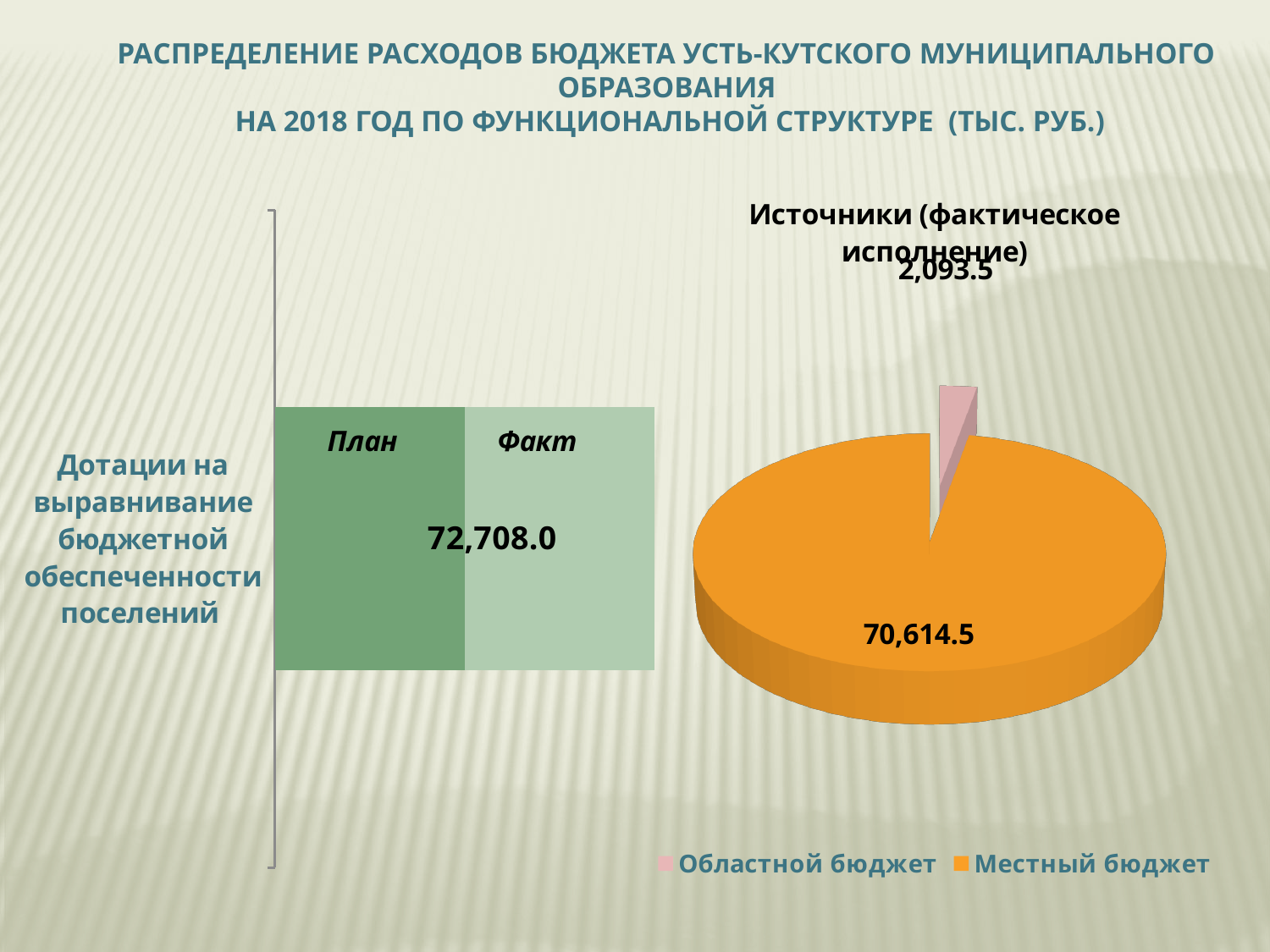
On the bar chart on the left of the slide, what are the two series shown? План and Факт On the pie chart 'Источники (фактическое исполнение)', what share of the total does Областной бюджет represent? 2.9% On the pie chart 'Источники (фактическое исполнение)', what is the difference between Местный бюджет and Областной бюджет? 68,521.0 On the pie chart 'Источники (фактическое исполнение)', what is the total of the two slices? 72,708.0 How many entries does the legend of the pie chart 'Источники (фактическое исполнение)' list? 2 On the pie chart 'Источники (фактическое исполнение)', which source has the largest slice? Местный бюджет On the pie chart 'Источники (фактическое исполнение)', which source has the smallest slice? Областной бюджет How many slices does the pie chart 'Источники (фактическое исполнение)' have? 2 What kind of chart is the chart on the right of the slide? Pie chart What kind of chart is the chart on the left of the slide, labelled 'Дотации на выравнивание бюджетной обеспеченности поселений'? Bar chart On the pie chart 'Источники (фактическое исполнение)', what is the value for Областной бюджет? 2,093.5 On the pie chart 'Источники (фактическое исполнение)', what is the value for Местный бюджет? 70,614.5